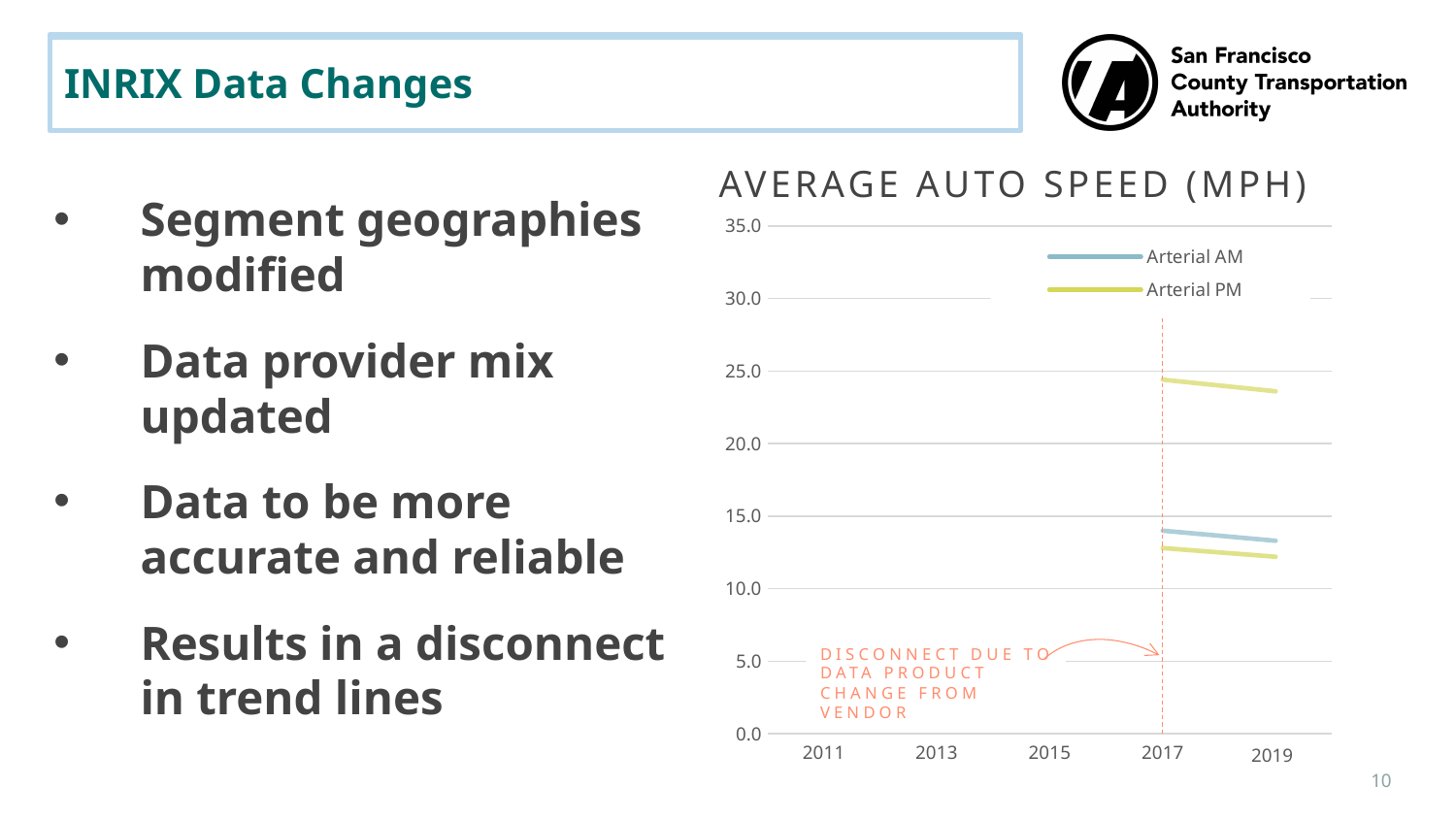
What is the highest value shown on the y axis of the chart? 35.0 How many series does the chart legend list? 2 What is the title of the chart? AVERAGE AUTO SPEED (MPH) Is the Arterial AM value in 2017 greater or less than 10.0? greater Which two series are named in the chart legend? Arterial AM and Arterial PM What is the first year shown on the x axis of the chart? 2011 Does the Arterial AM line rise or fall from 2017 to 2019? fall Is the Arterial AM value in 2019 greater or less than 15.0? less What kind of chart is shown on the slide? line chart How many year labels are shown on the x axis of the chart? 5 What is the last year shown on the x axis of the chart? 2019 Is the Arterial AM value in 2017 greater or less than 15.0? less